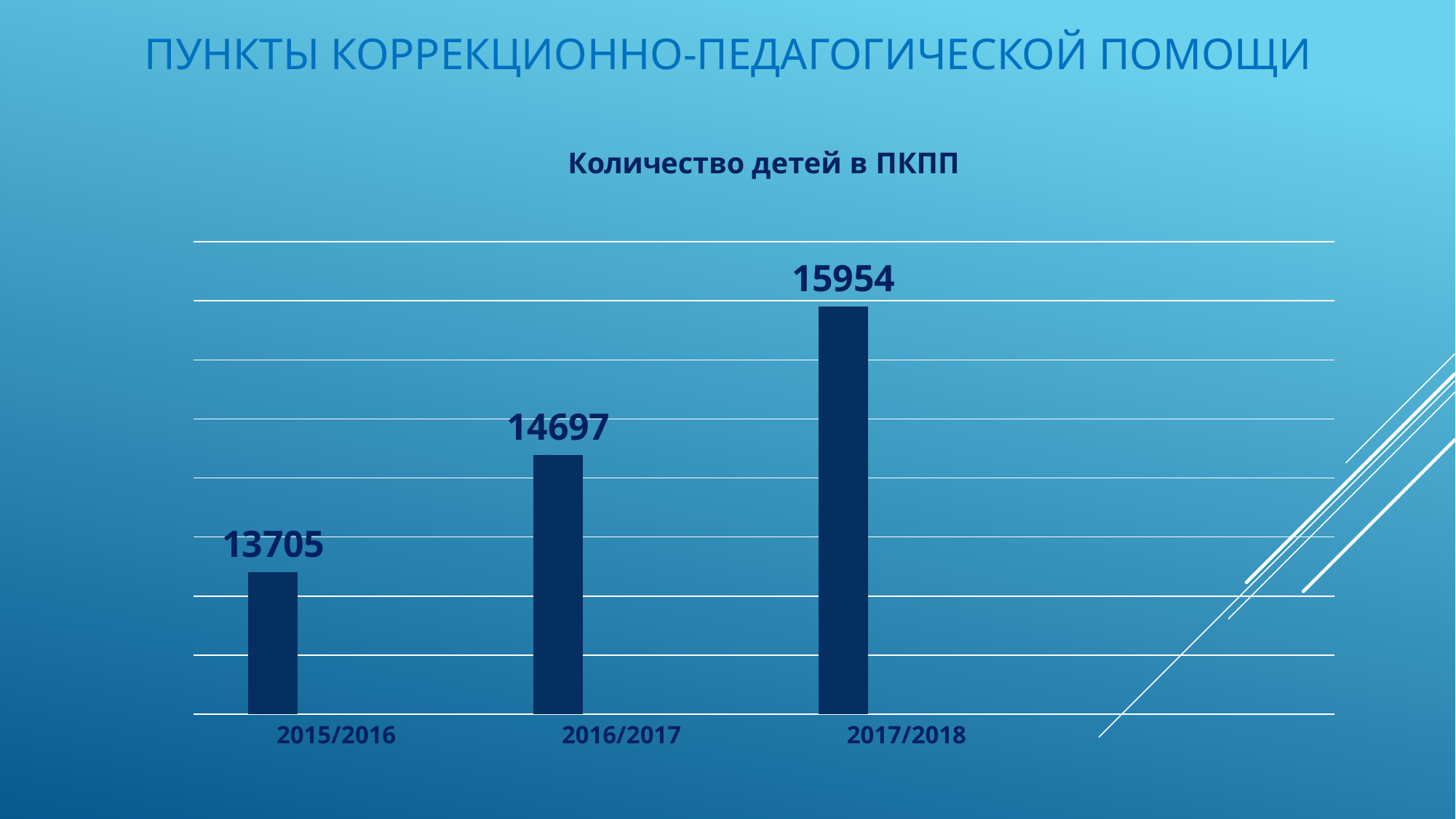
What is the difference between the values for 2016/2017 and 2015/2016? 992 How many categories are shown on the x axis? 3 What is the value for 2015/2016? 13705 What is the title of the chart? Количество детей в ПКПП Do the values rise or fall from 2015/2016 to 2017/2018? rise What is the difference between the values for 2017/2018 and 2015/2016? 2249 What kind of chart is shown? bar chart What is the value for 2017/2018? 15954 Which is larger, the value for 2016/2017 or the value for 2017/2018? 2017/2018 Which year has the lowest value? 2015/2016 Which year has the highest value? 2017/2018 What is the value for 2016/2017? 14697